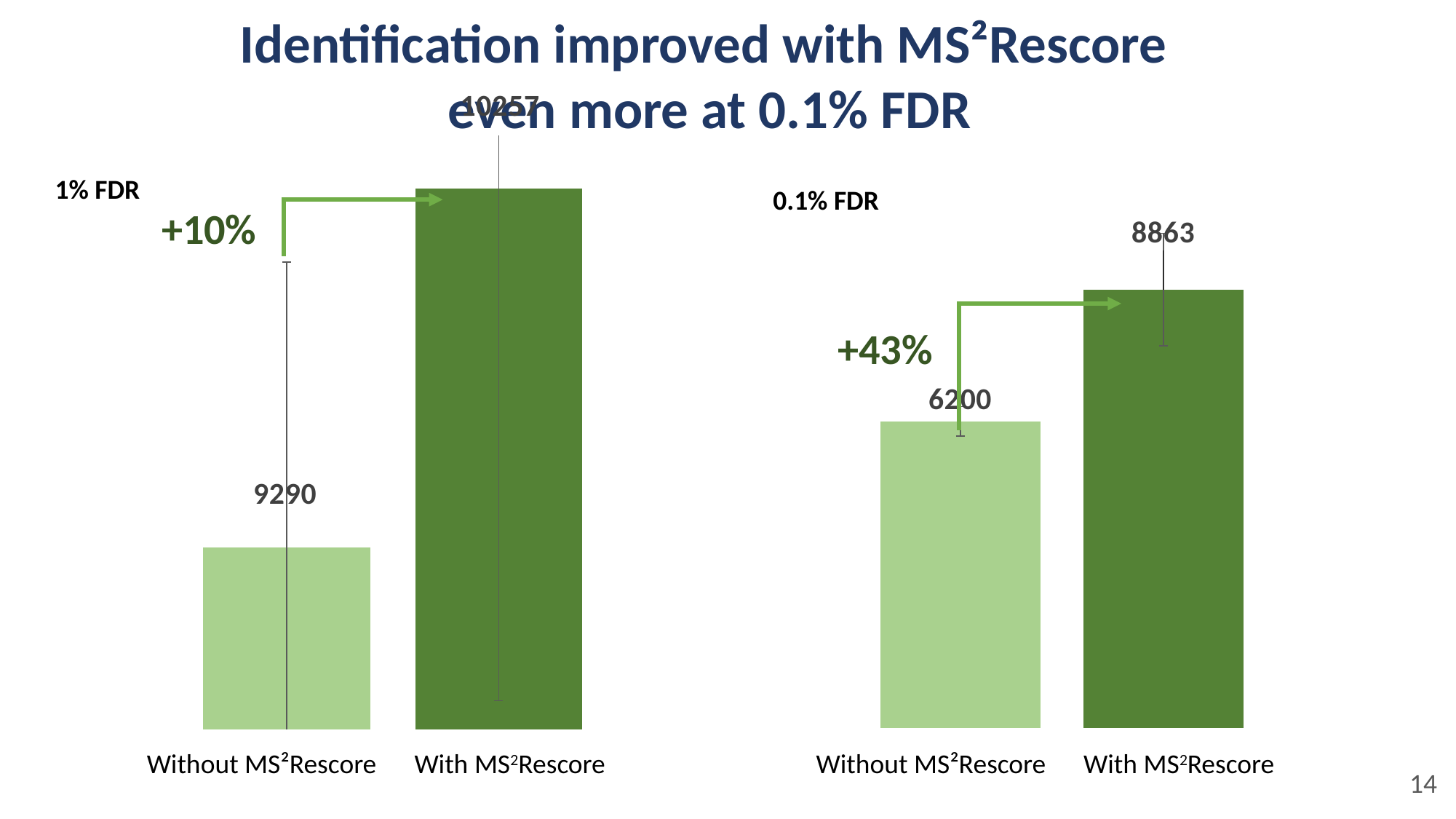
In the 0.1% FDR chart, which category has the lowest value? Without MS²Rescore In the 0.1% FDR chart, what is the value for With MS²Rescore? 8863 In the 1% FDR chart, which bar is higher, Without MS²Rescore or With MS²Rescore? With MS²Rescore What kind of chart is the 0.1% FDR chart? Bar chart In the 0.1% FDR chart, what is the difference between the With MS²Rescore and Without MS²Rescore values? 2663 How many bars are in the 1% FDR chart? 2 In the 0.1% FDR chart, which category has the highest value? With MS²Rescore What percentage improvement is annotated on the 0.1% FDR chart? +43% What percentage improvement is annotated on the 1% FDR chart? +10% In the 1% FDR chart, what is the value for Without MS²Rescore? 9290 Which chart shows the larger percentage improvement, 1% FDR or 0.1% FDR? 0.1% FDR In the 0.1% FDR chart, what is the value for Without MS²Rescore? 6200